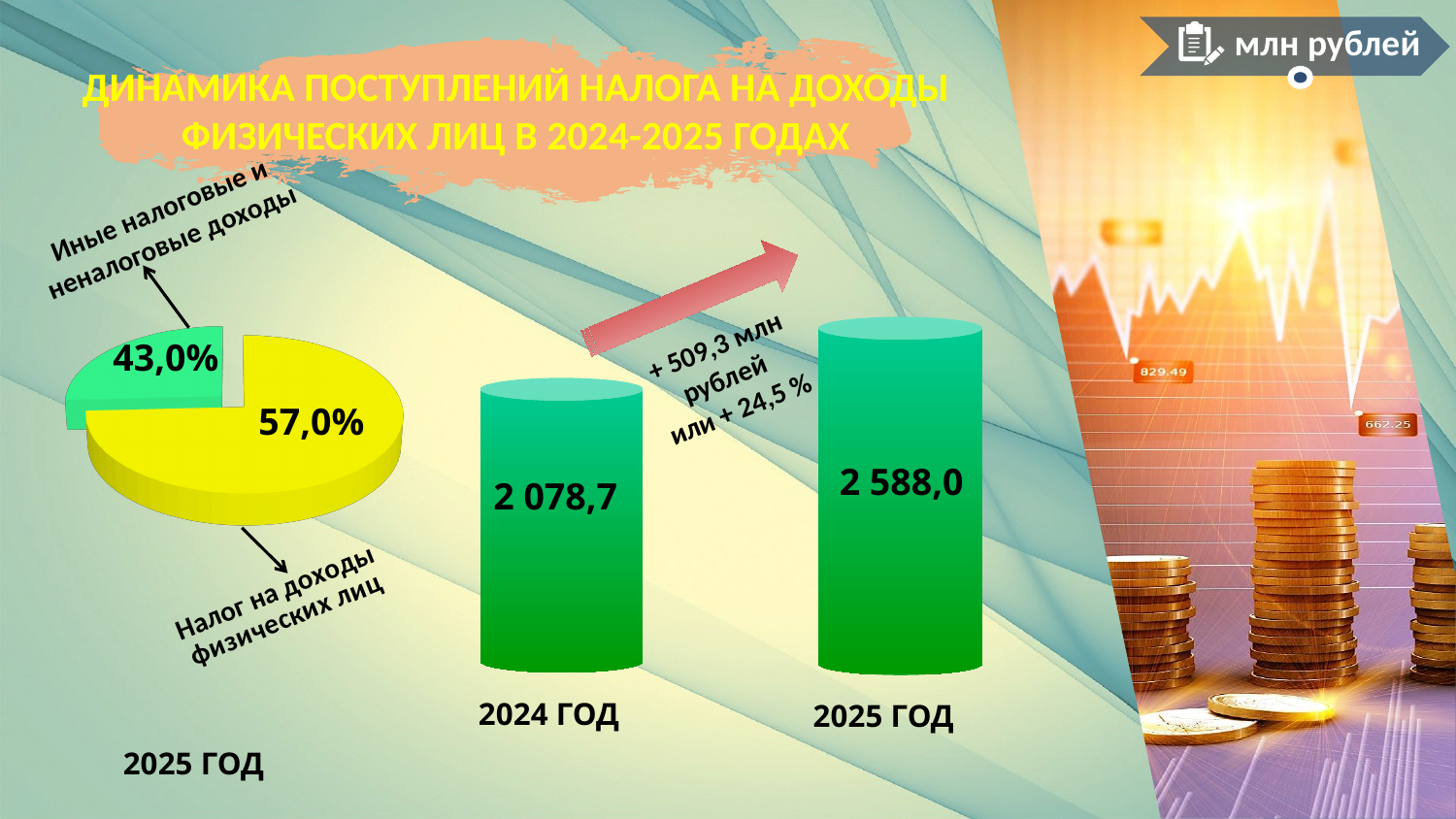
In the pie chart labelled 2025 ГОД, what share does Налог на доходы физических лиц have? 57,0% In the bar chart, do the values rise or fall from 2024 ГОД to 2025 ГОД? rise In the bar chart, which year has the lower value? 2024 ГОД What kind of chart is the chart on the left labelled 2025 ГОД? pie chart In the pie chart labelled 2025 ГОД, what share does Иные налоговые и неналоговые доходы have? 43,0% In the bar chart, by how much does the value for 2025 ГОД exceed the value for 2024 ГОД? 509,3 What kind of chart is the chart on the right showing 2024 ГОД and 2025 ГОД? bar chart In the pie chart labelled 2025 ГОД, which slice is larger: Налог на доходы физических лиц or Иные налоговые и неналоговые доходы? Налог на доходы физических лиц In the bar chart, which year has the higher value? 2025 ГОД In the bar chart, what is the value for 2025 ГОД? 2 588,0 In the bar chart, what is the value for 2024 ГОД? 2 078,7 How many bars are shown in the bar chart? 2